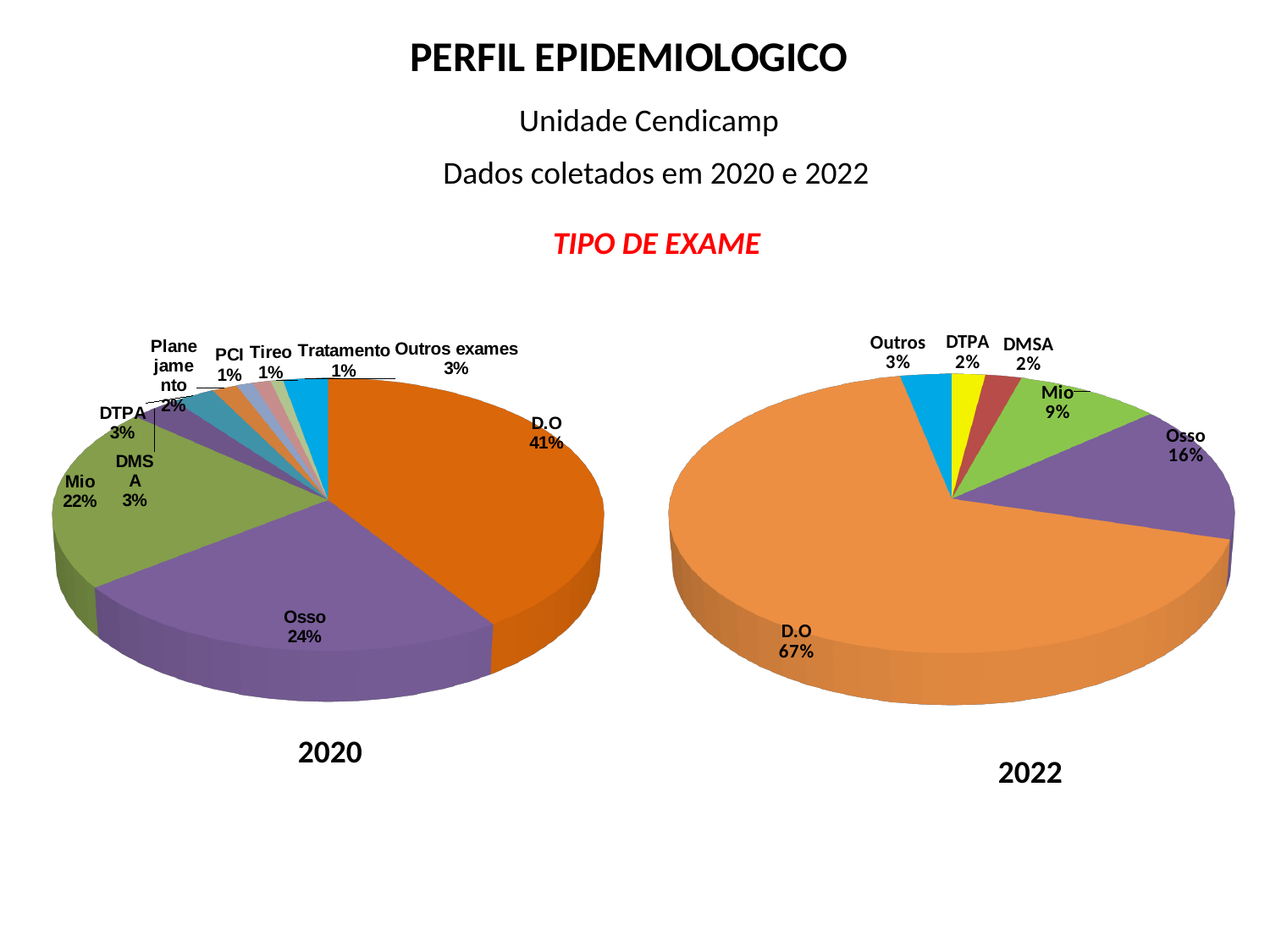
In the 2020 pie chart, which category has the largest share? D.O In the 2020 pie chart, what is the difference between the Osso share and the Mio share? 2% How many slices does the 2022 pie chart have? 6 In the 2022 pie chart, which is larger, Mio or Outros? Mio What is the red subtitle shown above the two charts? TIPO DE EXAME In the 2022 pie chart, which category has the largest share? D.O What type of chart is used for the 2020 data? Pie chart In the 2022 pie chart, what is the difference between the D.O share and the Osso share? 51% In the 2022 pie chart, what share does Osso have? 16% How many slices does the 2020 pie chart have? 10 In the 2020 pie chart, what share does Mio have? 22% In the 2020 pie chart, what share does D.O have? 41%